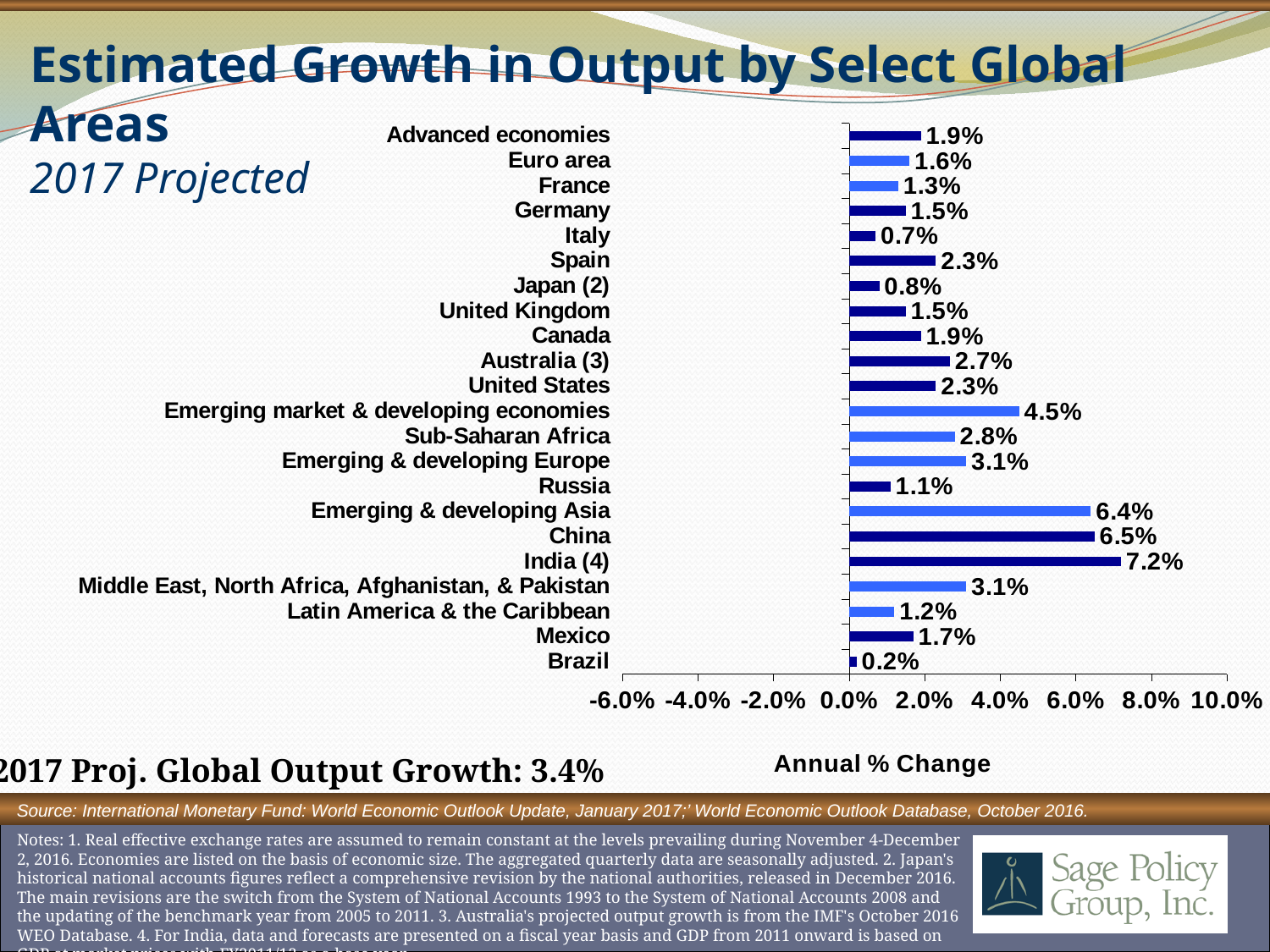
How many areas are plotted in the chart? 22 What is the projected 2017 output growth for Sub-Saharan Africa? 2.8% Which has higher projected 2017 output growth, Mexico or Latin America & the Caribbean? Mexico What is the label on the horizontal axis of the chart? Annual % Change What is the difference between the projected growth for Emerging & developing Asia and Russia? 5.3% What is the projected 2017 output growth for China? 6.5% Which has higher projected 2017 output growth, Germany or Australia (3)? Australia (3) What type of chart is shown on the slide? Bar chart Which area has the highest projected 2017 output growth? India (4) Which area has the lowest projected 2017 output growth? Brazil What is the projected 2017 output growth for Spain? 2.3% What is the difference between the projected growth for the United States and Italy? 1.6%